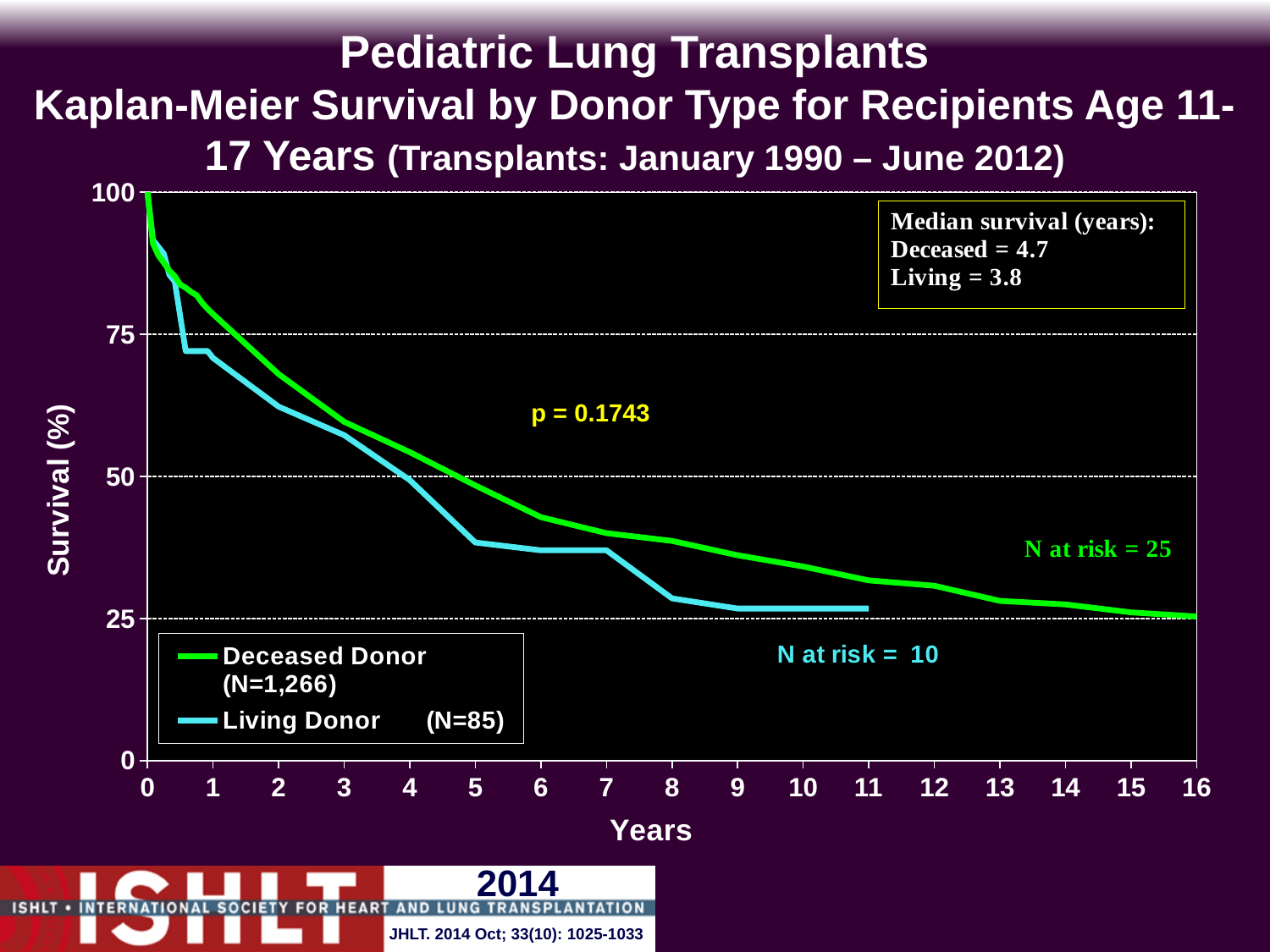
What is the median survival in years for the Living donor group? 3.8 What is the median survival in years for the Deceased donor group? 4.7 Is the Deceased Donor survival at 8 years greater or less than 50%? less What is the p-value shown on the chart? p = 0.1743 What kind of chart is shown on the slide? line chart What is the N for the Deceased Donor series in the legend? N=1,266 What is the N at risk shown for the Deceased Donor curve? 25 How many series does the legend list? 2 What is the N at risk shown for the Living Donor curve? 10 What is the N for the Living Donor series in the legend? N=85 Which donor group has the higher median survival, Deceased or Living? Deceased Do the survival curves rise or fall as years increase? fall